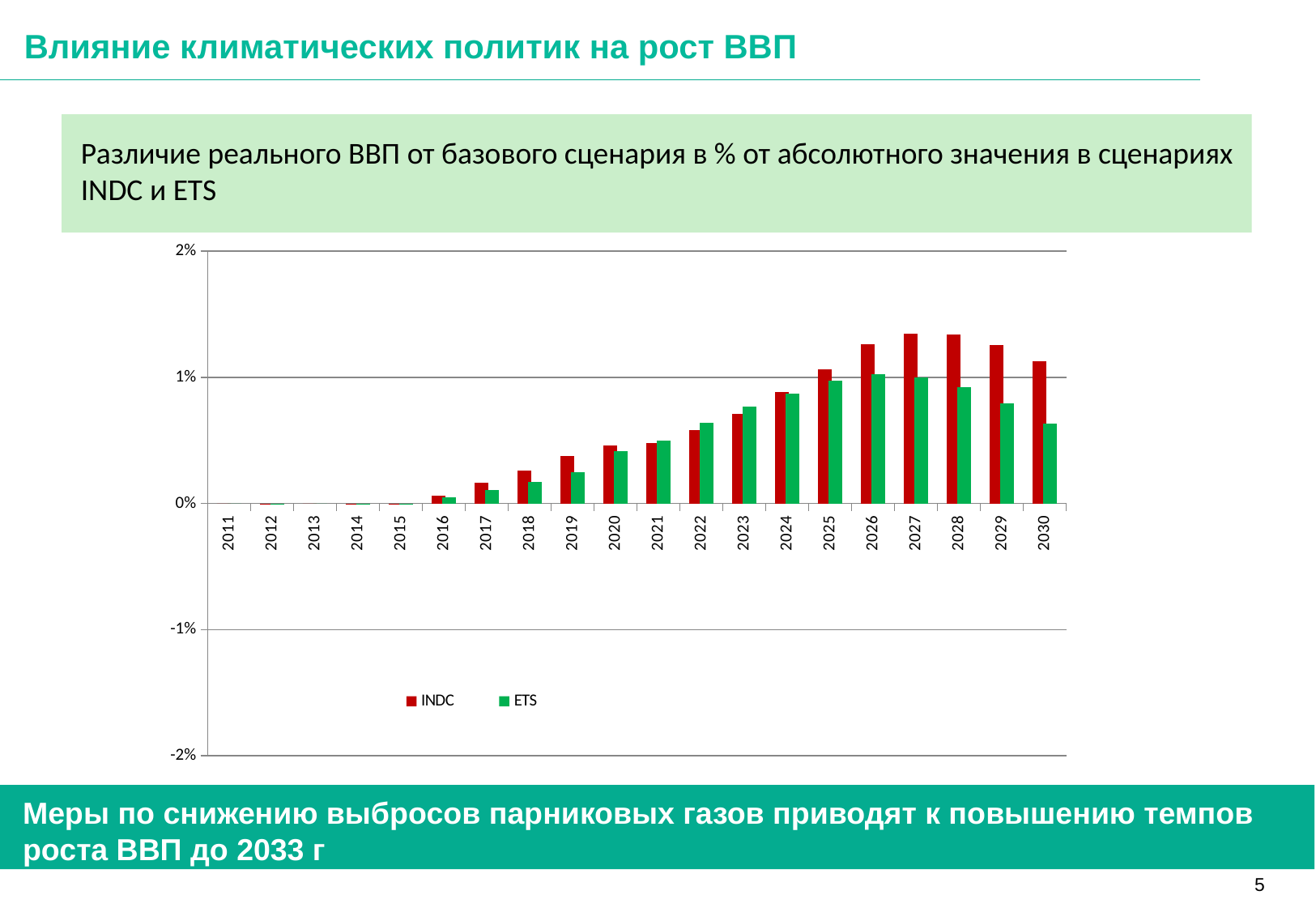
In 2030, which series has the larger value, INDC or ETS? INDC Is the INDC value for 2027 greater or less than 1%? greater In 2022, which series has the larger value, INDC or ETS? ETS Is the ETS value for 2029 greater or less than 1%? less What kind of chart is shown on the slide? bar chart How many series does the chart legend list? 2 Is the INDC value for 2020 greater or less than 1%? less Which series is shown in red in the chart? INDC What are the two series named in the chart legend? INDC and ETS Do the INDC values rise or fall from 2016 to 2026? rise How many years are shown on the x axis of the chart? 20